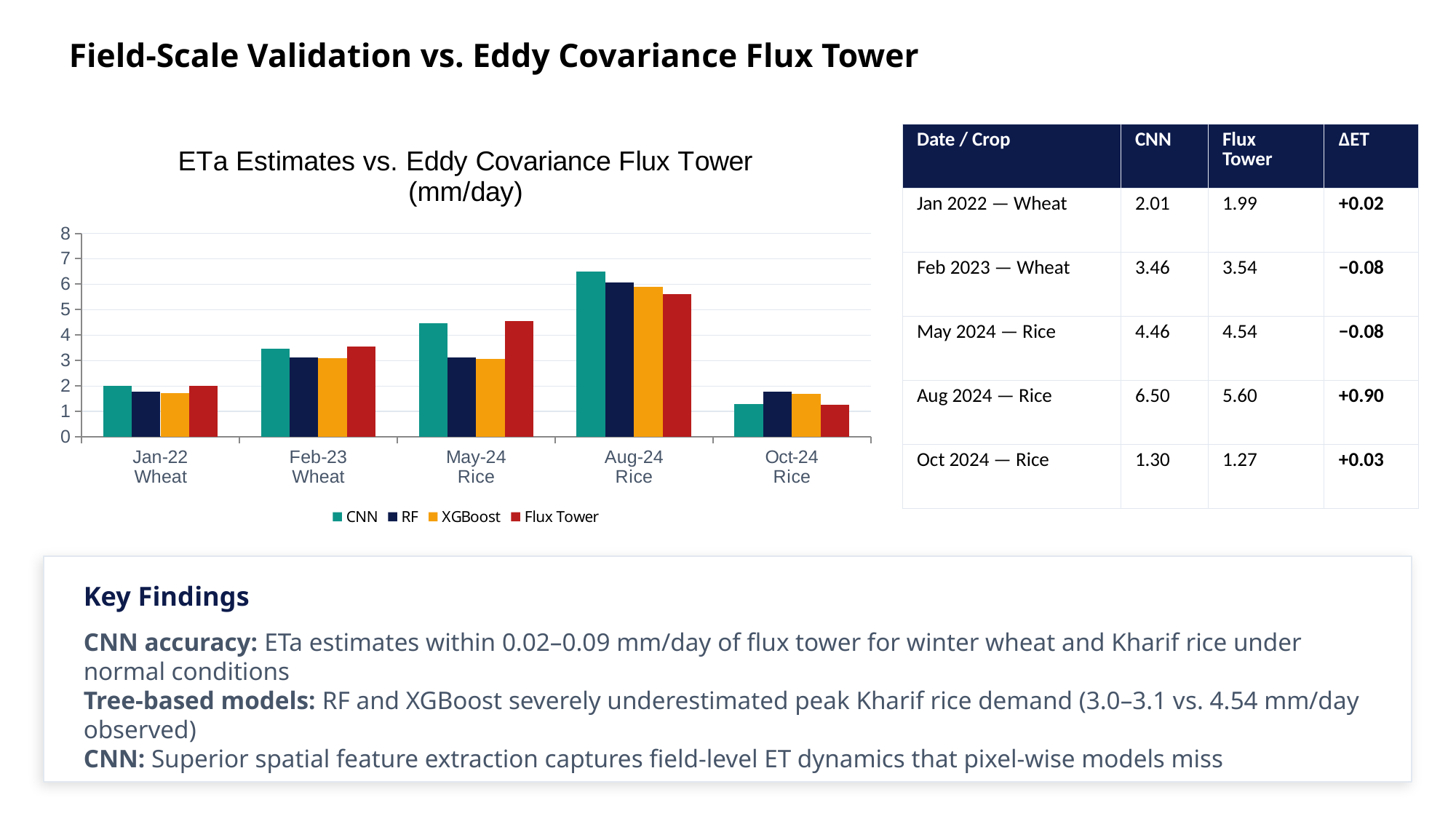
Which category has the lowest Flux Tower bar? Oct-24 Rice How many date/crop categories are shown on the x axis of the chart? 5 For May-24 Rice, which is larger: the CNN bar or the XGBoost bar? CNN What is the CNN ETa estimate for Aug 2024 Rice, as printed in the table? 6.50 How many series does the chart legend list? 4 Which category has the highest CNN bar? Aug-24 Rice For Oct-24 Rice, which is larger: the RF bar or the Flux Tower bar? RF Is the RF value for May-24 Rice greater or less than 4? less What colour represents the Flux Tower series in the chart legend? red Is the CNN value for Aug-24 Rice greater or less than 6? greater What is the difference (ΔET) between the CNN estimate and the Flux Tower value for Aug 2024 Rice? +0.90 What type of chart is shown on the slide? bar chart